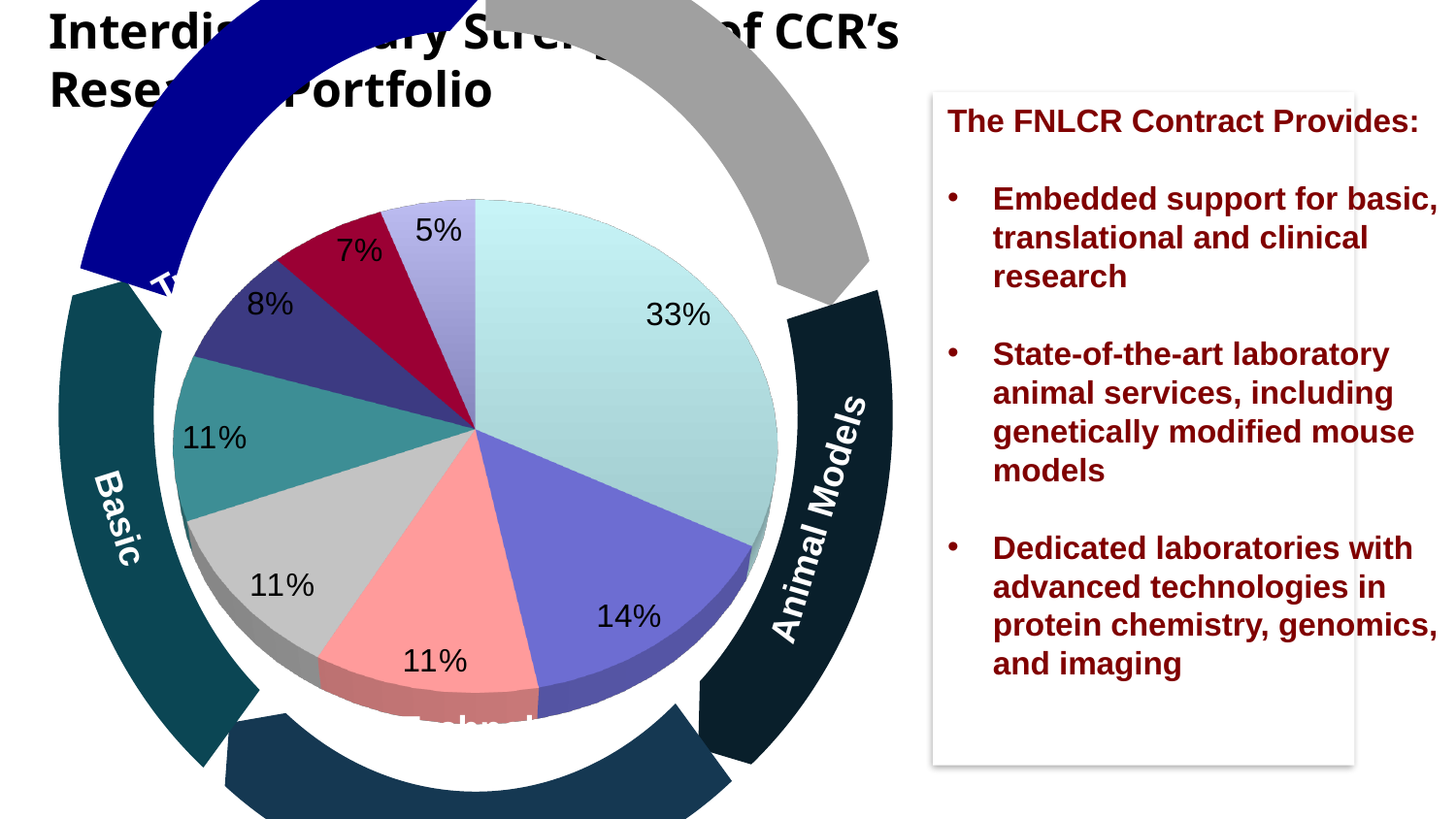
What is the largest percentage shown on the pie chart? 33% What percentage is labelled on the blue-purple slice at the lower right of the pie chart? 14% Which slice is larger, the crimson slice or the dark purple slice? the dark purple slice What percentage is labelled on the light cyan slice of the pie chart? 33% What is the smallest percentage shown on the pie chart? 5% How many slices of the pie chart are labelled 11%? 3 What percentage is labelled on the crimson slice of the pie chart? 7% What percentage is labelled on the dark purple slice of the pie chart? 8% What is the difference in percentage points between the largest slice (33%) and the 14% slice? 19 How many slices does the pie chart have? 8 Is the value of the largest slice greater or less than 25%? greater What kind of chart is shown on the slide? pie chart